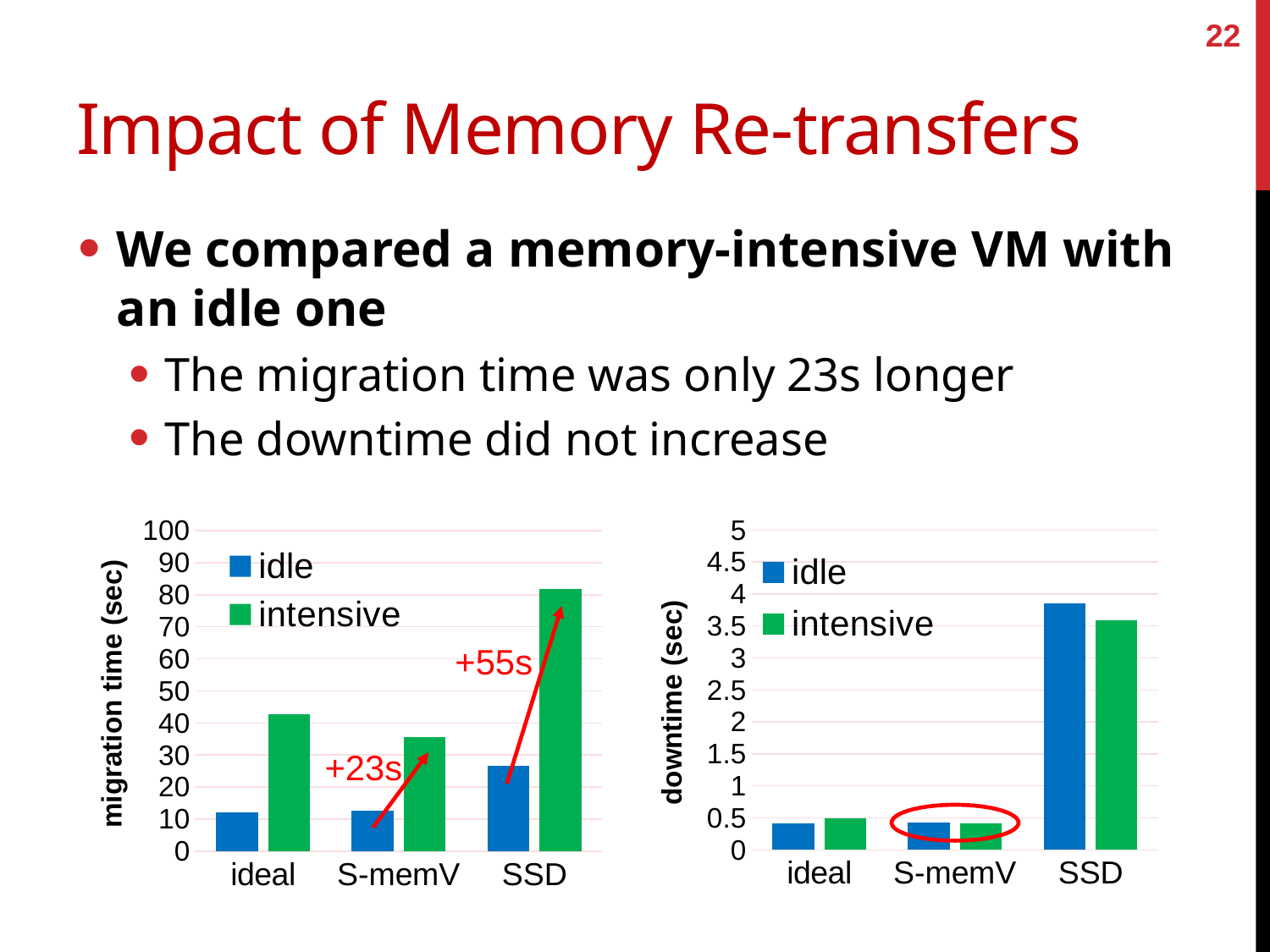
In the migration time chart, is the intensive value for SSD greater or less than 70? greater In the migration time chart, which is larger for S-memV, the idle value or the intensive value? intensive In the downtime chart, is the idle value for SSD greater or less than 3? greater In the migration time chart, which category has the highest intensive value? SSD In the downtime chart, is the intensive value for S-memV greater or less than 1? less How many series does the legend of the migration time chart list? 2 How many categories are shown on the x axis of the downtime chart on the right? 3 What kind of chart is the migration time chart on the left? bar chart What is the y-axis label of the chart on the right? downtime (sec) In the downtime chart, which category has the highest idle value? SSD In the migration time chart, what increase is annotated for the SSD category? +55s